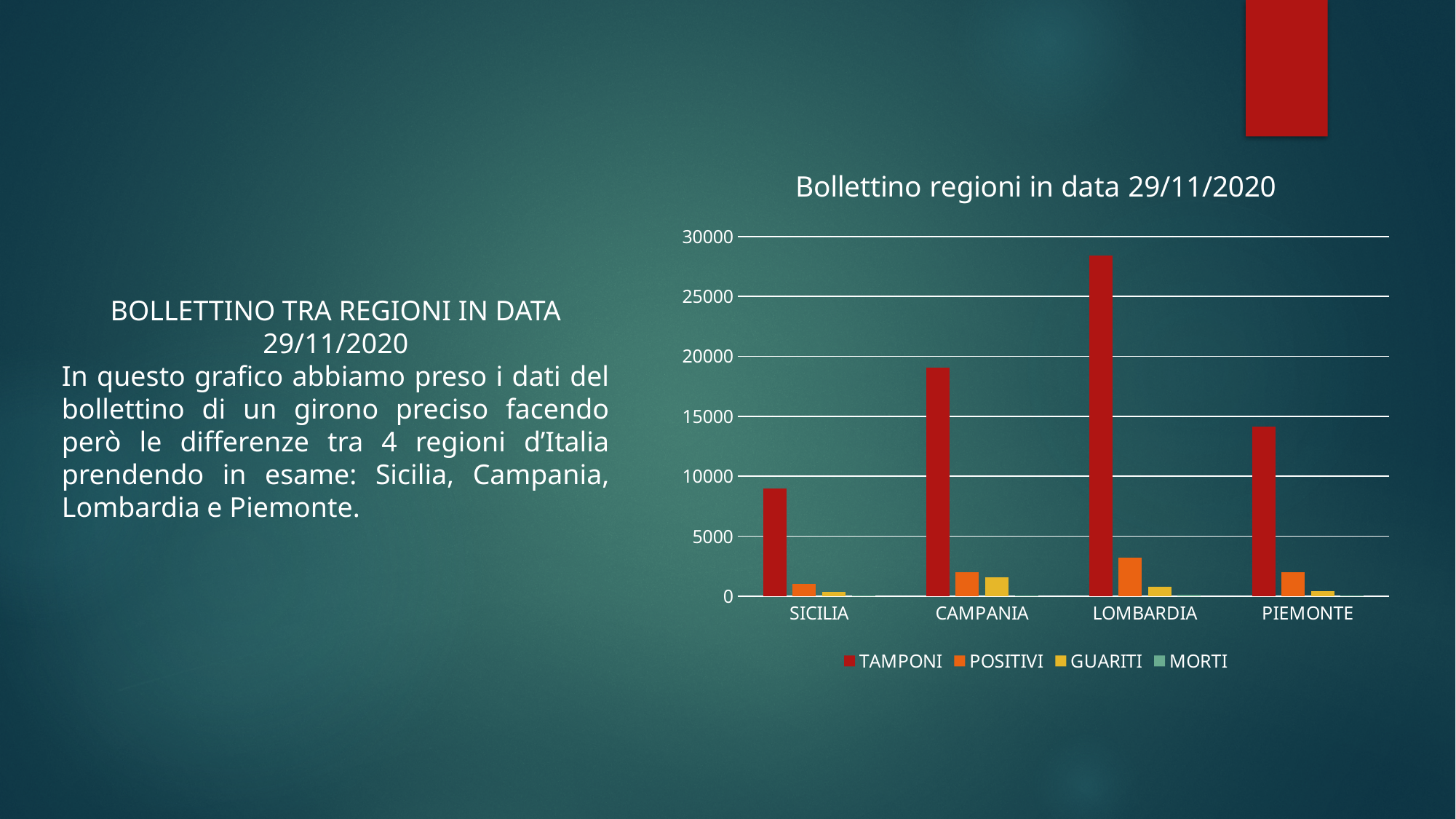
Which region has the highest TAMPONI value? LOMBARDIA How many series does the chart legend list? 4 Which region has the highest POSITIVI value? LOMBARDIA How many regions are shown on the x axis of the chart? 4 Which region has a larger TAMPONI value, CAMPANIA or PIEMONTE? CAMPANIA Is the TAMPONI value for PIEMONTE greater or less than 15000? less What is the title of the chart? Bollettino regioni in data 29/11/2020 Is the TAMPONI value for LOMBARDIA greater or less than 25000? greater Is the TAMPONI value for SICILIA greater or less than 10000? less Which region has the lowest TAMPONI value? SICILIA What kind of chart is shown on the slide? bar chart Which series is shown in dark red in the chart? TAMPONI